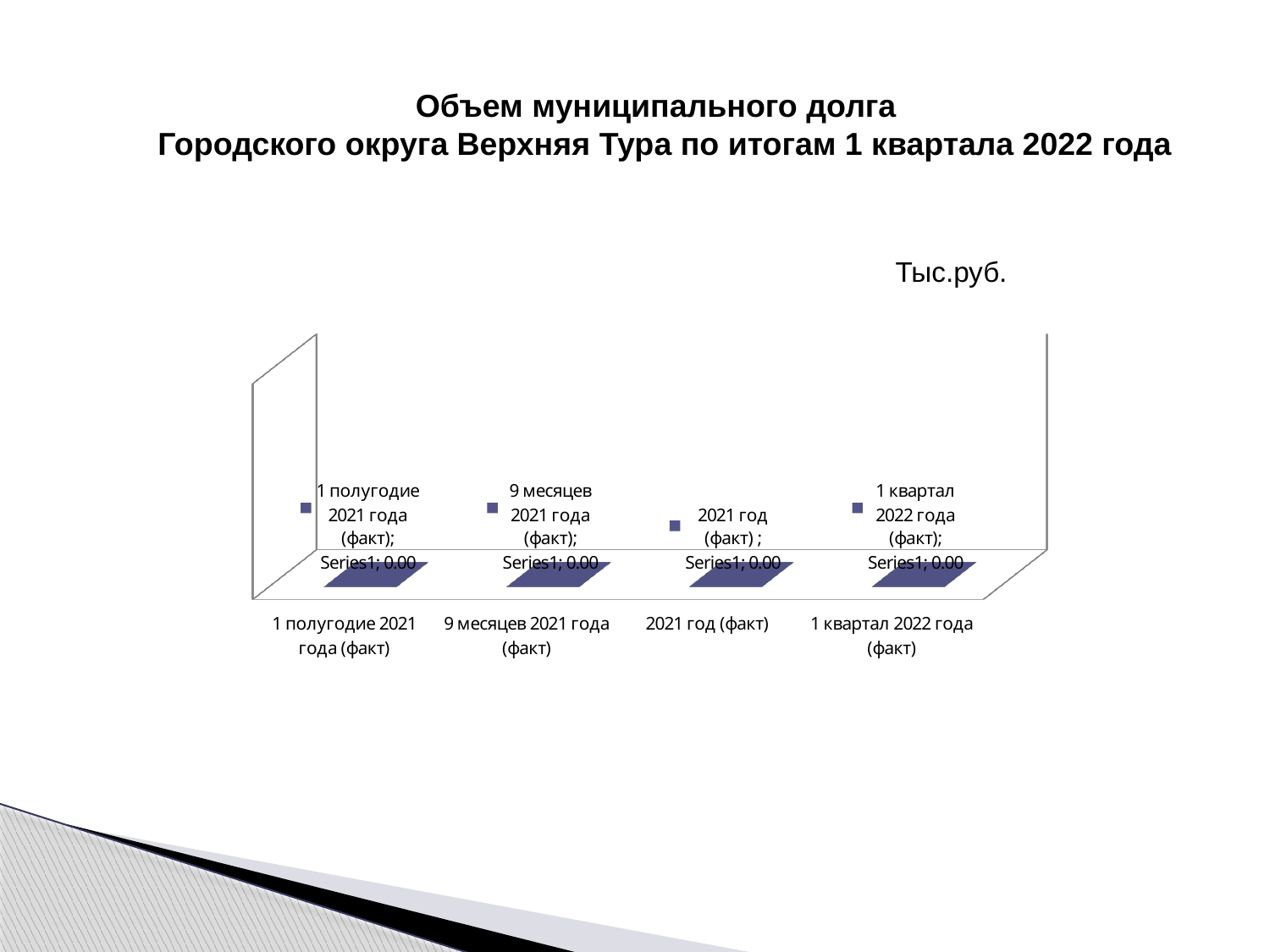
What series name appears in the data labels of the chart? Series1 How many categories are shown on the x axis of the chart? 4 What is the total of the values across all four categories? 0.00 What is the value for 1 квартал 2022 года (факт)? 0.00 What is the value for 1 полугодие 2021 года (факт)? 0.00 What kind of chart is shown on the slide? bar chart Do the values rise, fall, or stay the same from 1 полугодие 2021 года to 1 квартал 2022 года? stay the same What unit of measurement is indicated above the chart? Тыс.руб. What is the value for 2021 год (факт)? 0.00 What is the value for 9 месяцев 2021 года (факт)? 0.00 What is the difference between the value for 1 квартал 2022 года (факт) and the value for 2021 год (факт)? 0.00